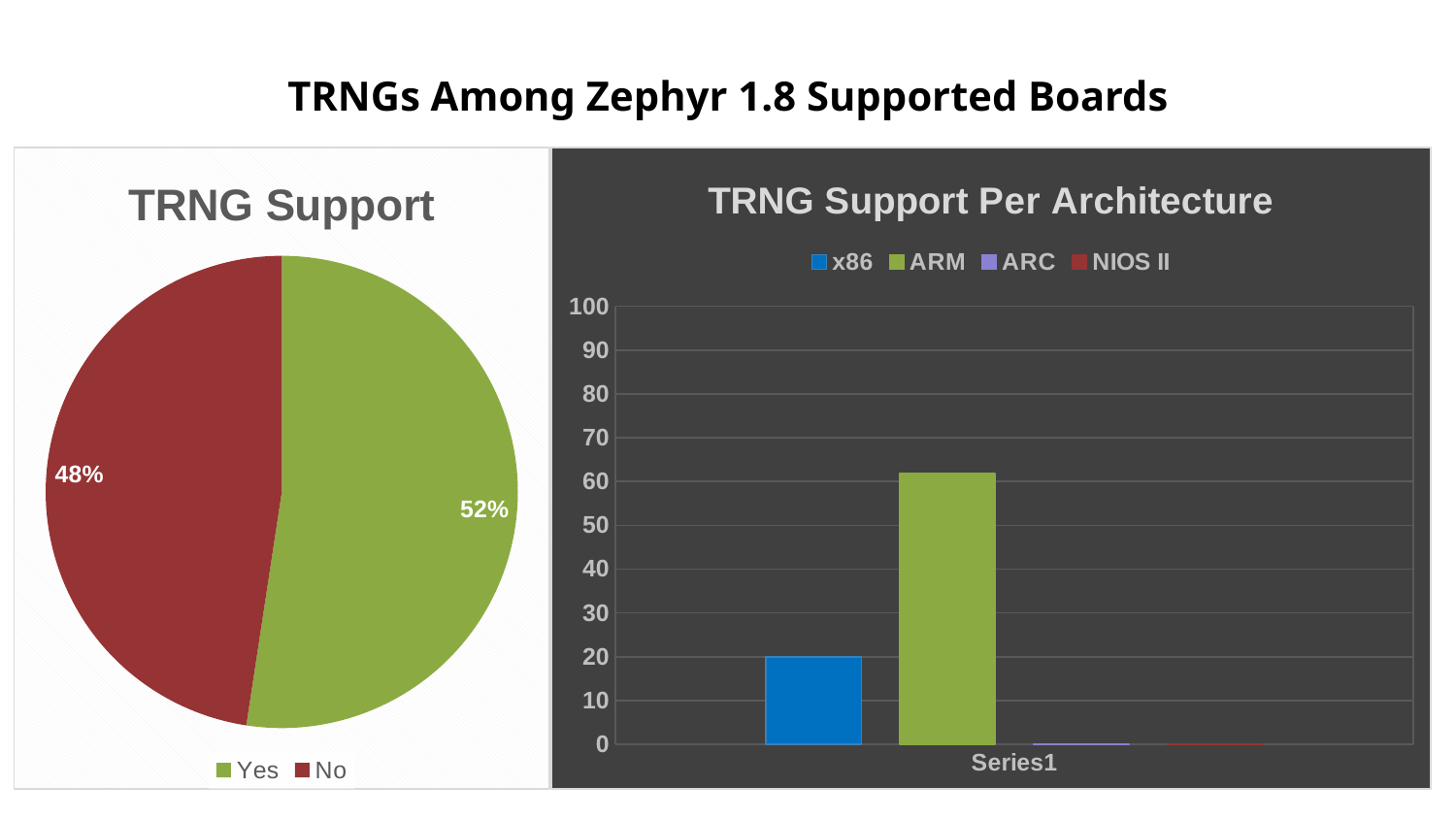
In the TRNG Support Per Architecture chart, is the value for x86 greater or less than 30? less What kind of chart is the TRNG Support chart on the left? Pie chart How many series does the legend of the TRNG Support Per Architecture chart list? 4 In the TRNG Support pie chart, which slice is larger, Yes or No? Yes In the TRNG Support Per Architecture chart, is the value for ARM greater or less than 50? greater In the TRNG Support Per Architecture chart, which architecture has the highest bar? ARM In the TRNG Support pie chart, what share of boards is labelled No? 48% What kind of chart is the TRNG Support Per Architecture chart on the right? Bar chart In the TRNG Support Per Architecture chart, which bar is taller, x86 or ARM? ARM In the TRNG Support pie chart, what share of boards is labelled Yes? 52% How many slices does the TRNG Support pie chart have? 2 In the TRNG Support pie chart, by how many percentage points does Yes exceed No? 4 percentage points